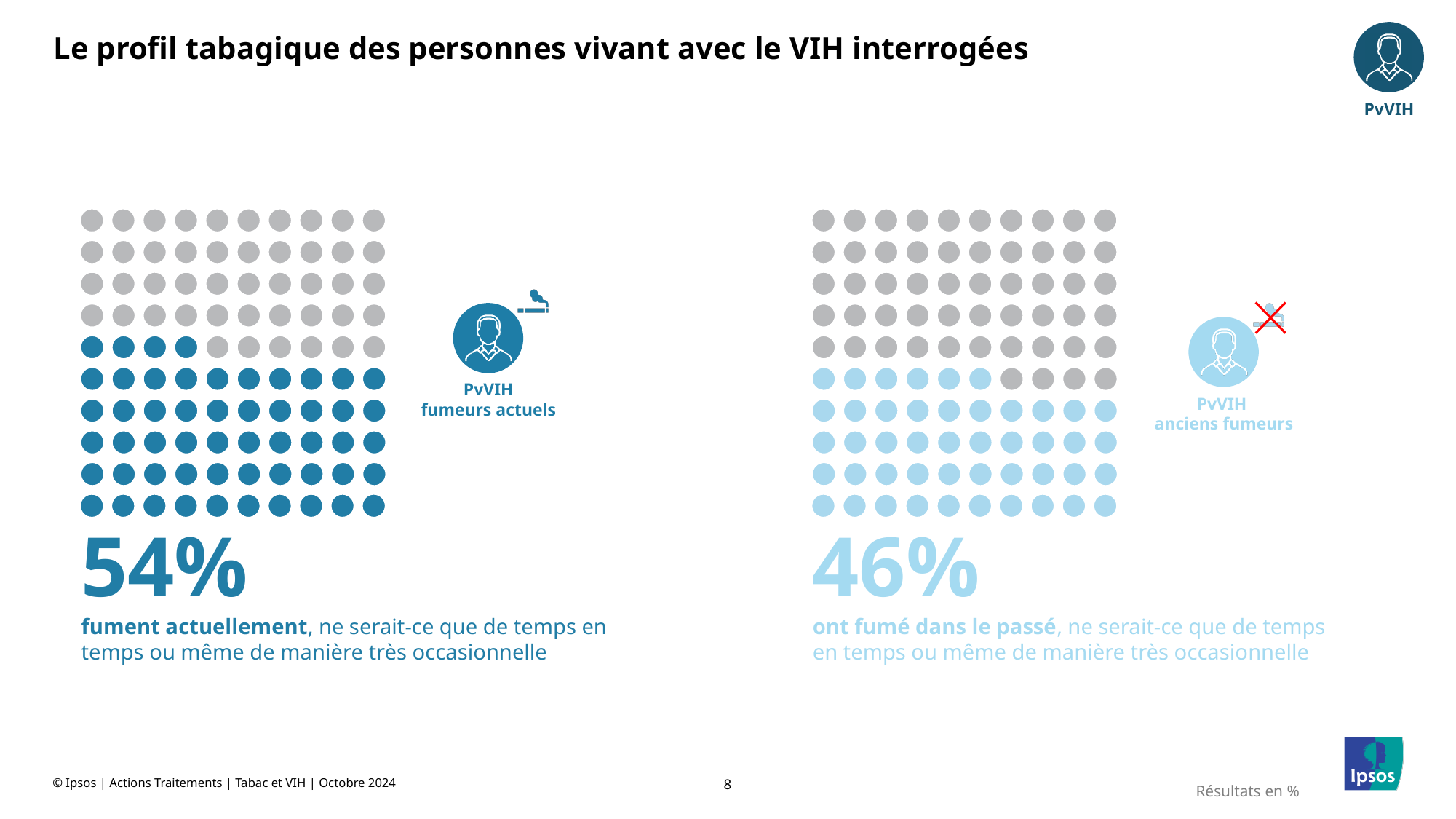
On the right chart, what percentage of people living with HIV are former smokers (anciens fumeurs)? 46% What colour represents the current smokers (fumeurs actuels) on the left chart? Dark blue Is the value for current smokers on the left chart greater or less than 50%? greater Which group is larger: current smokers (left chart) or former smokers (right chart)? Current smokers (fumeurs actuels) How many dots are coloured light blue in the right chart? 46 Is the value for former smokers on the right chart greater or less than 50%? less How many dots make up the grid of the left chart? 100 What is the title of the slide? Le profil tabagique des personnes vivant avec le VIH interrogées What kind of chart is used on this slide to show the percentages? Dot (waffle) pictogram chart On the left chart, what percentage of people living with HIV currently smoke (fumeurs actuels)? 54% What is the difference in percentage points between the current smokers (54%) and the former smokers (46%)? 8 percentage points How many dots are coloured dark blue in the left chart? 54